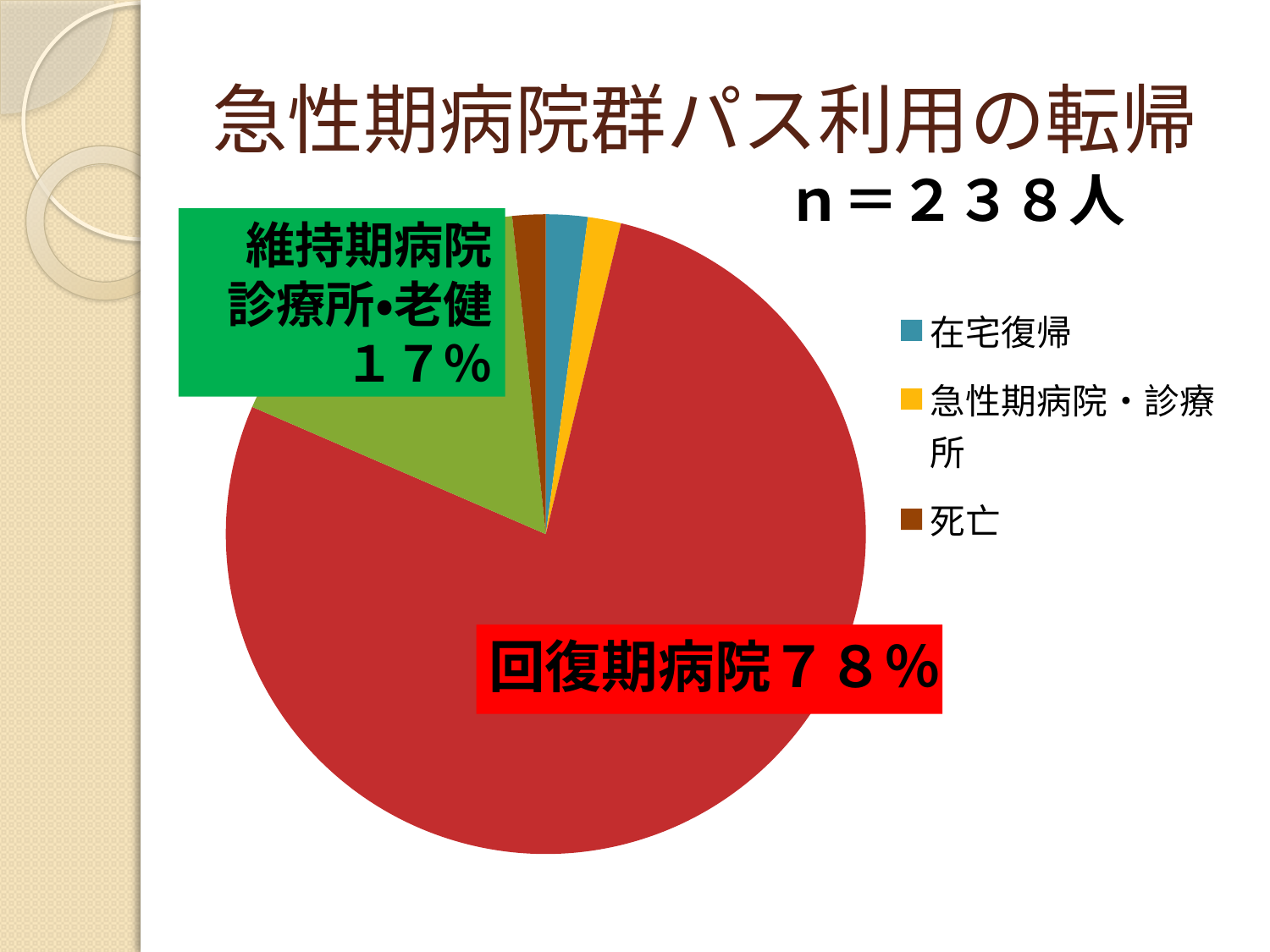
What is the sample size (n) stated on the slide? 238人 Which category has the largest slice of the pie? 回復期病院 What kind of chart is shown on the slide? pie chart Which slice is larger, 回復期病院 or 維持期病院・診療所・老健? 回復期病院 Which slice is larger, 回復期病院 or 死亡? 回復期病院 How many entries does the legend list? 3 What percentage of the pie is labelled 回復期病院? 78% How many slices does the pie chart have? 5 By how many percentage points does the 回復期病院 slice exceed the 維持期病院・診療所・老健 slice? 61 percentage points What percentage of the pie is labelled 維持期病院・診療所・老健? 17% What is the title of the chart on the slide? 急性期病院群パス利用の転帰